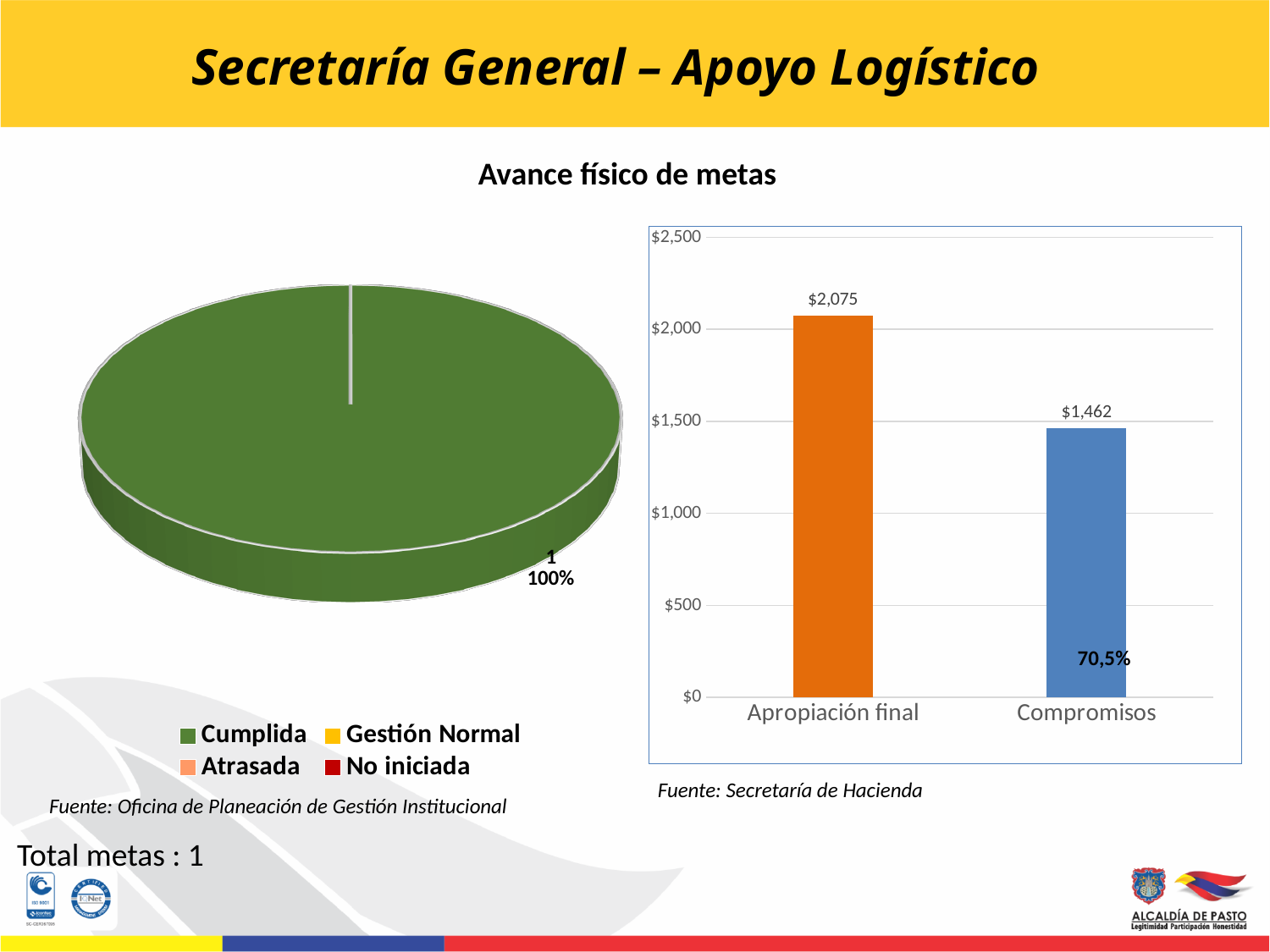
What kind of chart is the chart on the left of the slide? pie chart In the bar chart on the right, what is the value for Compromisos? $1,462 In the bar chart on the right, what percentage label is printed on the Compromisos bar? 70,5% In the bar chart on the right, how many categories are shown on the x axis? 2 In the pie chart on the left, what share does the Cumplida slice represent? 100% In the bar chart on the right, what is the value for Apropiación final? $2,075 How many entries does the legend of the pie chart on the left list? 4 What kind of chart is the chart on the right of the slide? bar chart In the bar chart on the right, what is the difference between Apropiación final and Compromisos? $613 In the bar chart on the right, is the value for Compromisos greater or less than $1,500? less In the bar chart on the right, which category has the lower value? Compromisos In the bar chart on the right, which category has the higher value? Apropiación final